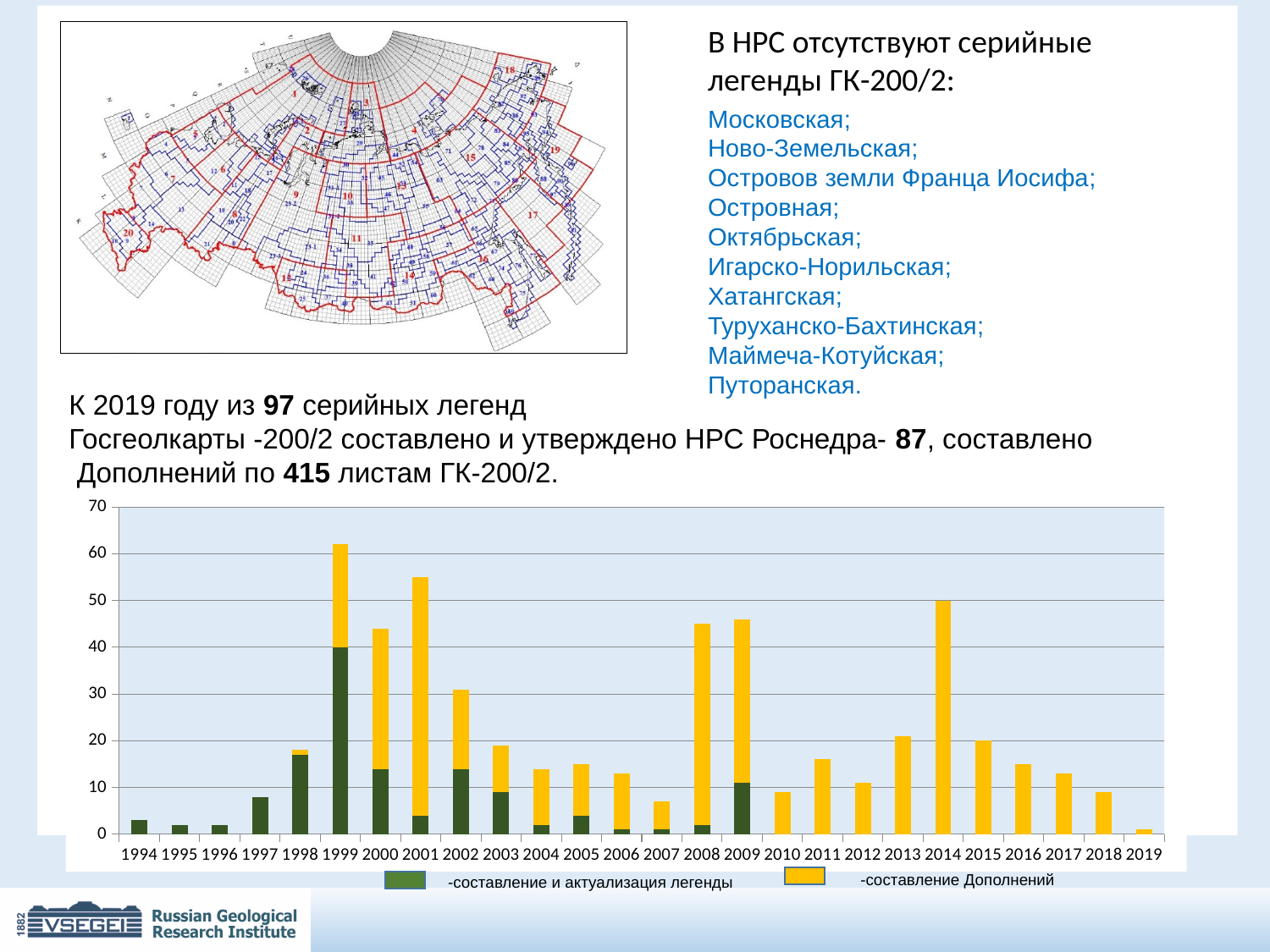
Which year has the shortest bar in the chart? 2019 Which year has the tallest bar in the chart? 1999 Which year has the taller bar, 2008 or 2014? 2014 How many series does the legend of the bar chart list? 2 Is the total bar height for 2000 greater or less than 40? greater Which series in the bar chart is shown in green? составление и актуализация легенды Is the total bar height for 1999 greater or less than 60? greater How many years are shown on the x axis of the bar chart? 26 Which year has the taller bar, 2010 or 2011? 2011 Is the total bar height for 2007 greater or less than 10? less What kind of chart is shown at the bottom of the slide? stacked bar chart